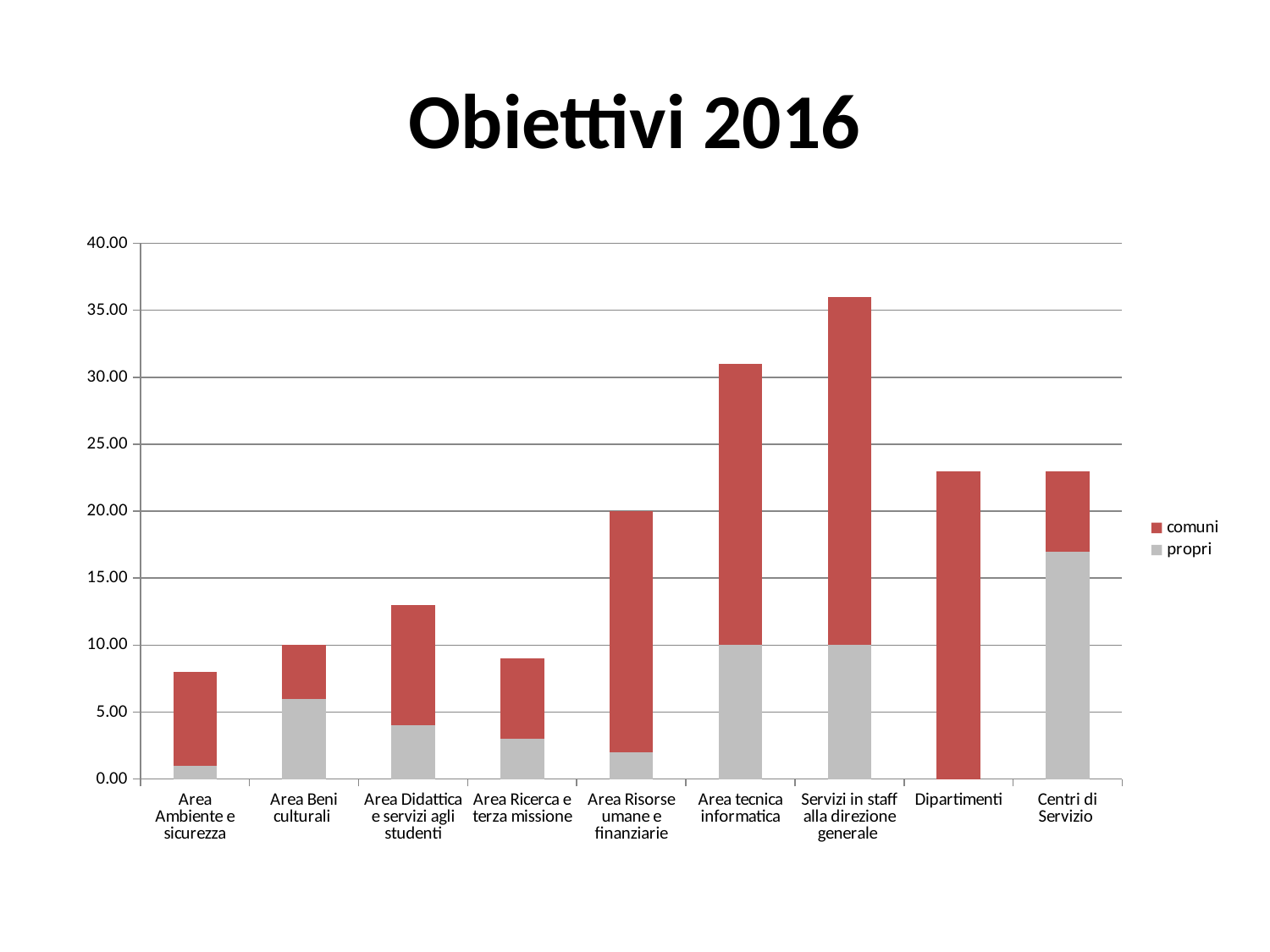
What kind of chart is shown on the slide? stacked bar chart Which category has the tallest stacked bar overall? Servizi in staff alla direzione generale What is the total height of the stacked bar for Area Beni culturali? 10.00 Which is larger, the total bar for Area tecnica informatica or the total bar for Dipartimenti? Area tecnica informatica Is the total value for Area Didattica e servizi agli studenti greater or less than 15.00? less Which category has the largest 'propri' segment? Centri di Servizio What is the 'propri' value for Area tecnica informatica? 10.00 How many categories are shown on the x axis of the chart? 9 What is the total height of the stacked bar for Area Risorse umane e finanziarie? 20.00 Is the total value for Dipartimenti greater or less than 20.00? greater How many series does the legend list? 2 Which category has no 'propri' segment at all? Dipartimenti